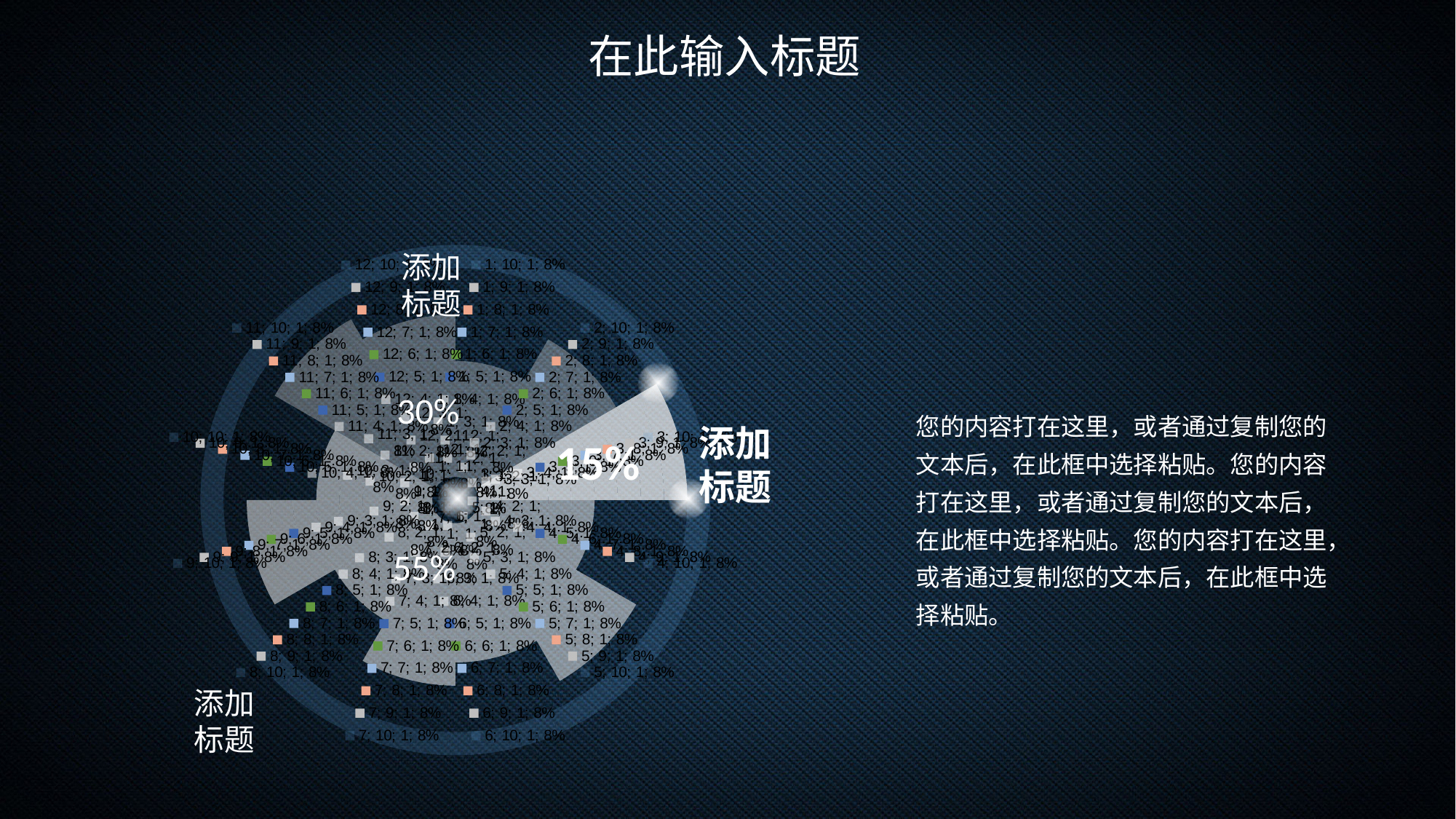
Which is larger, the slice labelled 30% or the slice labelled 15%? 30% What is the largest percentage shown on the pie chart? 55% What percentage is shown on the lower-left slice of the pie chart? 55% What percentage is shown on the slice at the right side of the pie chart, next to the bold 添加标题 label? 15% What is the difference between the 30% slice and the 15% slice? 15% What is the difference between the 55% slice and the 30% slice? 25% What percentage is shown on the upper-left slice of the pie chart? 30% What is the smallest percentage shown on the pie chart? 8% What kind of chart is shown on the slide? Doughnut chart What is the total of the three percentages shown on the pie chart? 100% What is the title of the slide? 在此输入标题